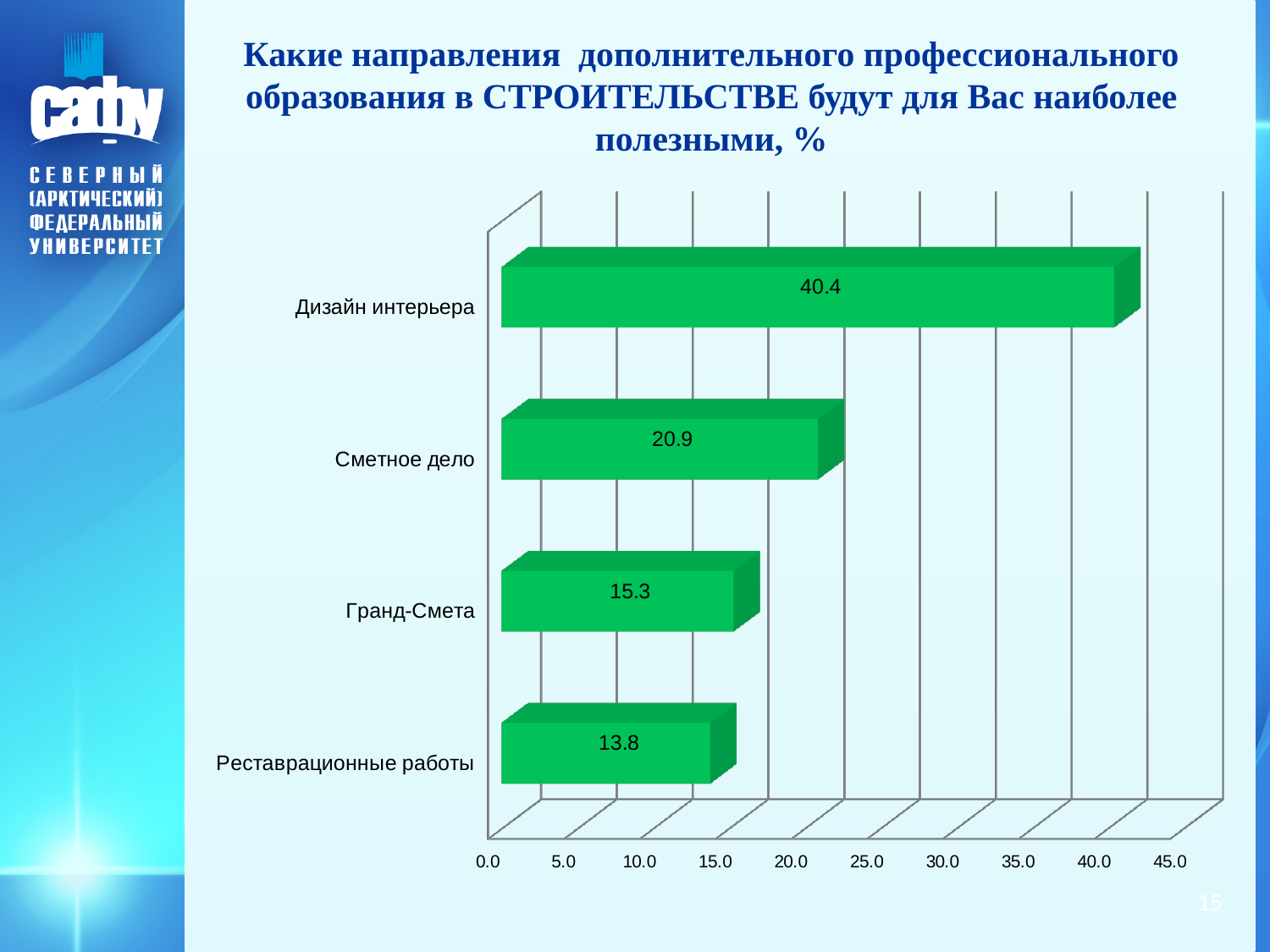
Which category has the lowest value? Реставрационные работы What is the difference between the values for Гранд-Смета and Реставрационные работы? 1.5 What is the value for Дизайн интерьера? 40.4 Which is larger, the value for Сметное дело or the value for Гранд-Смета? Сметное дело What is the value for Сметное дело? 20.9 What is the value for Реставрационные работы? 13.8 What is the value for Гранд-Смета? 15.3 How many categories are shown in the chart? 4 What is the difference between the values for Дизайн интерьера and Сметное дело? 19.5 Which category has the highest value? Дизайн интерьера Is the value for Дизайн интерьера greater or less than 35.0? greater What kind of chart is shown on the slide? bar chart